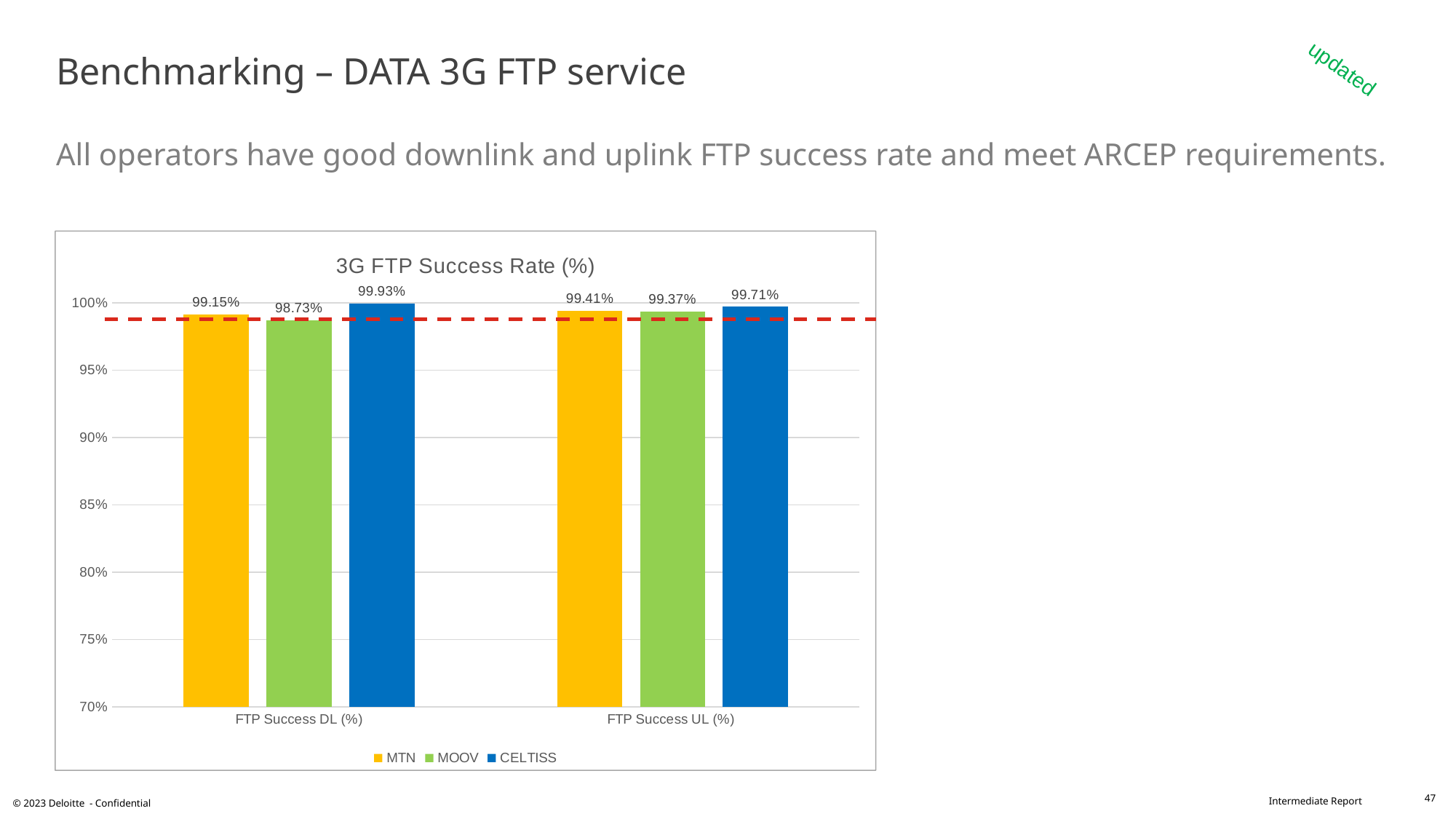
How many categories are shown on the x axis? 2 What is the FTP Success DL (%) value for MOOV? 98.73% Which operator has the highest FTP Success DL (%)? CELTISS What is the FTP Success DL (%) value for MTN? 99.15% Which is larger for MOOV: FTP Success DL (%) or FTP Success UL (%)? FTP Success UL (%) Which operator has the lowest FTP Success DL (%)? MOOV How many series does the legend list? 3 What is the difference between CELTISS and MTN for FTP Success UL (%)? 0.30% What kind of chart is shown on the slide? Bar chart What is the difference between CELTISS and MOOV for FTP Success DL (%)? 1.20% What is the title of the chart? 3G FTP Success Rate (%) What is the FTP Success UL (%) value for CELTISS? 99.71%